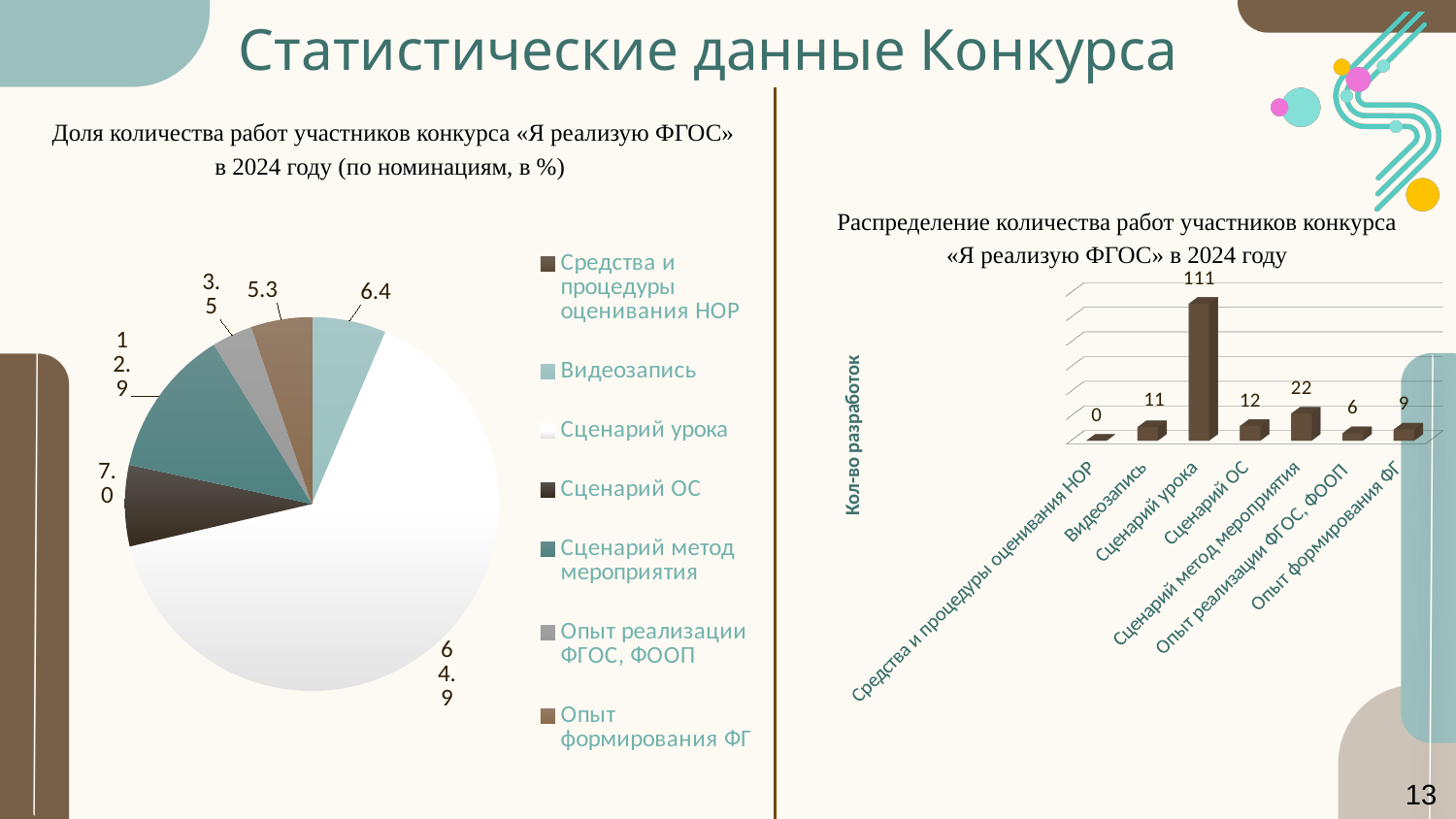
In the bar chart on the right, how many works are shown for «Сценарий урока»? 111 In the bar chart on the right, which category has the highest number of works? Сценарий урока In the bar chart on the right, what is the difference between the values for «Сценарий метод мероприятия» and «Сценарий ОС»? 10 In the bar chart on the right, what is the value for «Сценарий метод мероприятия»? 22 How many categories are shown in the bar chart on the right? 7 How many entries does the legend of the pie chart on the left list? 7 In the bar chart on the right, which is larger: the value for «Видеозапись» or for «Опыт формирования ФГ»? Видеозапись In the pie chart on the left, what percentage is shown for «Сценарий урока»? 64.9 In the bar chart on the right, which category has the lowest value? Средства и процедуры оценивания НОР In the pie chart on the left, what percentage is shown for «Сценарий метод мероприятия»? 12.9 In the pie chart on the left, which category has the smallest labelled share? Опыт реализации ФГОС, ФООП What type of chart is the chart on the right side of the slide? bar chart